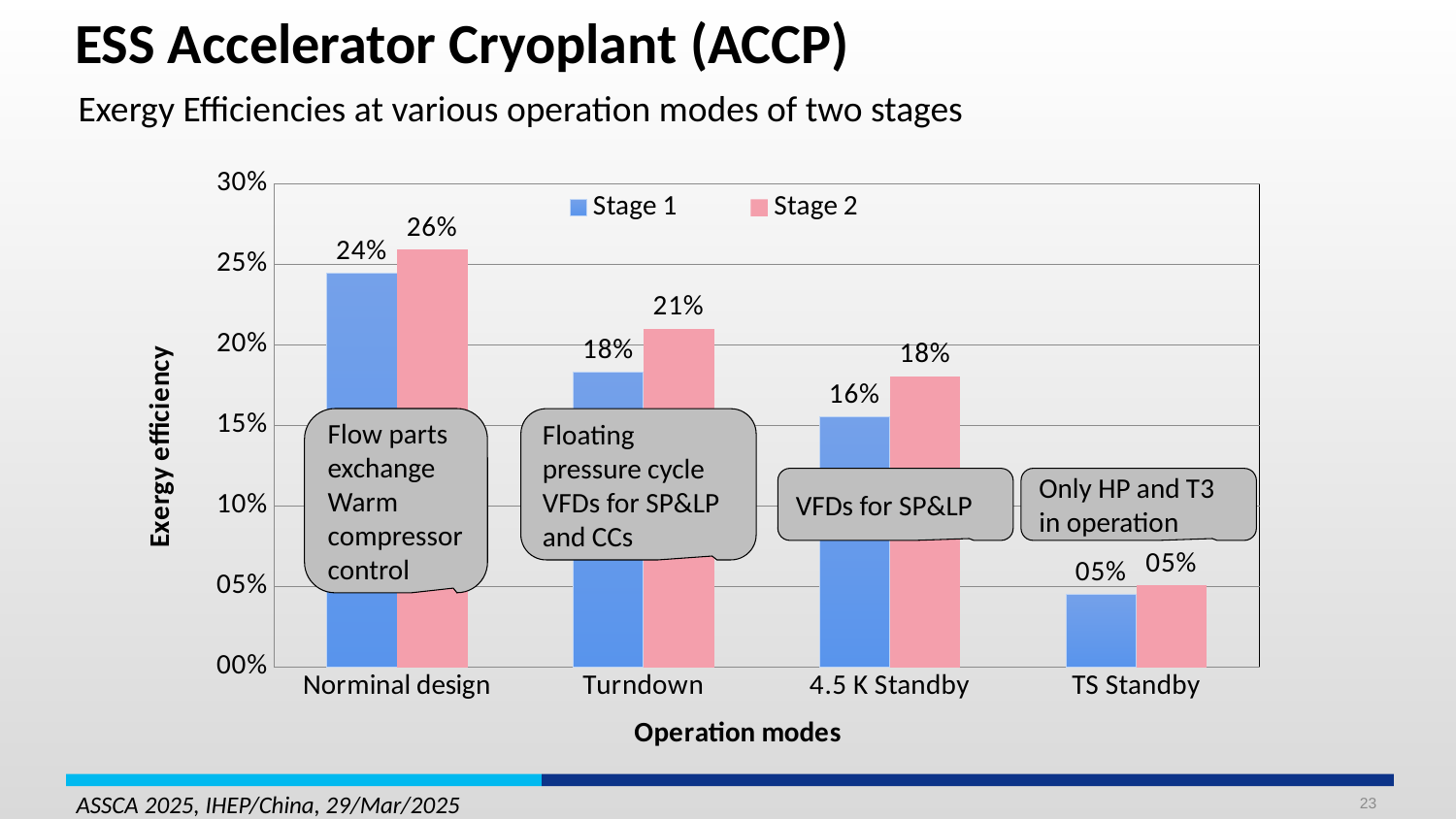
How many operation modes are shown on the x axis? 4 What is the Stage 1 exergy efficiency for the Norminal design operation mode? 24% Which is larger for 4.5 K Standby, the Stage 1 value or the Stage 2 value? Stage 2 What is the label of the y axis? Exergy efficiency What is the Stage 2 value for TS Standby? 05% What is the Stage 2 exergy efficiency for the Turndown operation mode? 21% What is the Stage 1 value for 4.5 K Standby? 16% What kind of chart is shown on the slide? Bar chart Which operation mode has the lowest Stage 1 exergy efficiency? TS Standby What is the difference between the Stage 2 and Stage 1 values for Turndown? 3% Which operation mode has the highest Stage 2 exergy efficiency? Norminal design How many series does the legend list? 2